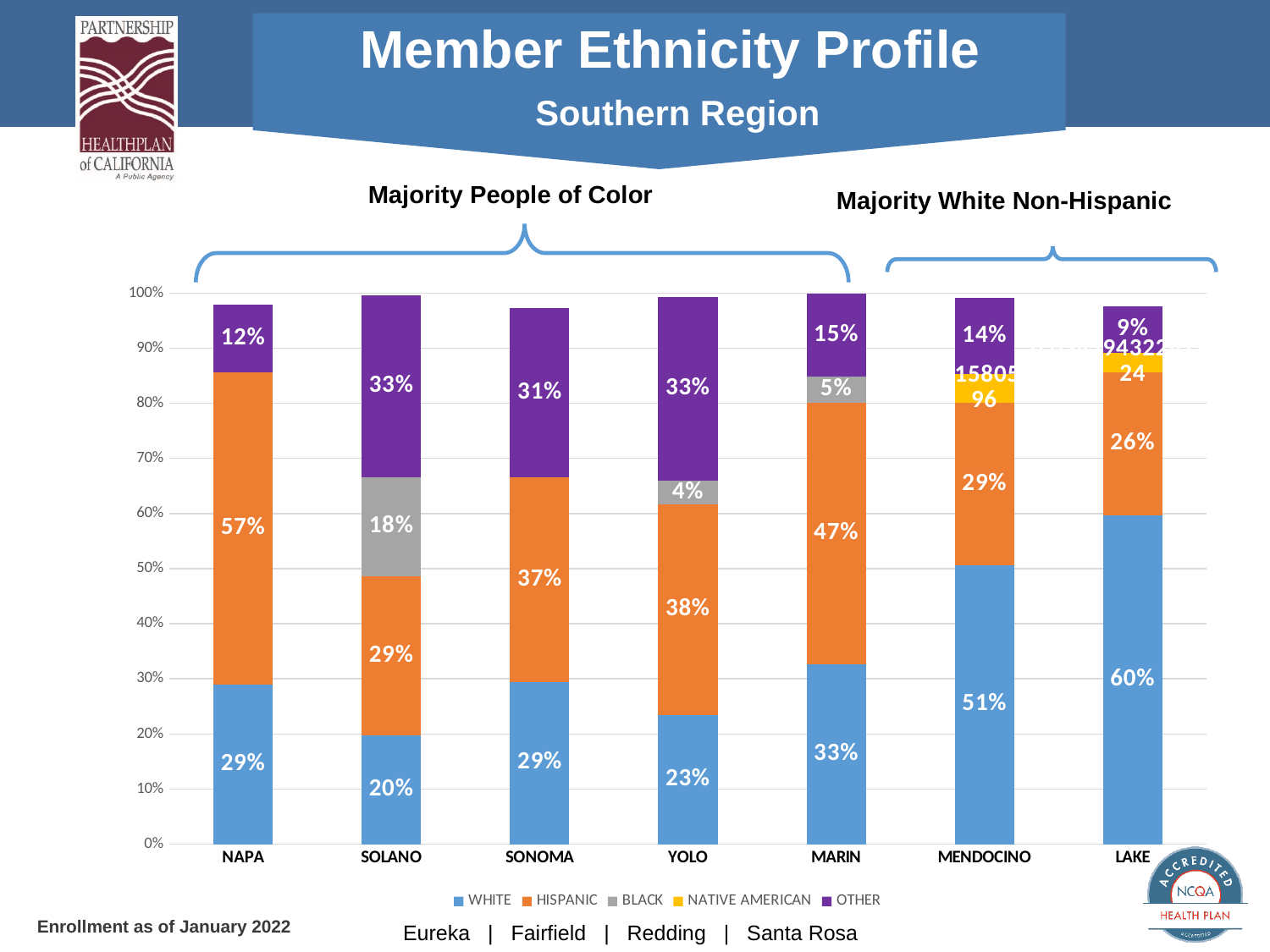
Which county has the highest Hispanic share? Napa Which county has the lowest White share? Solano How many counties are shown on the x axis of the chart? 7 Which county has the larger Hispanic share, Marin or Sonoma? Marin What is the White share for Lake? 60% What is the Black share for Solano? 18% What is the White share for Mendocino? 51% What is the difference between the Hispanic share and the White share for Napa? 28% What is the Hispanic share for Napa? 57% What kind of chart is shown on the slide? Stacked bar chart How many series does the chart legend list? 5 Which county has the highest White share? Lake